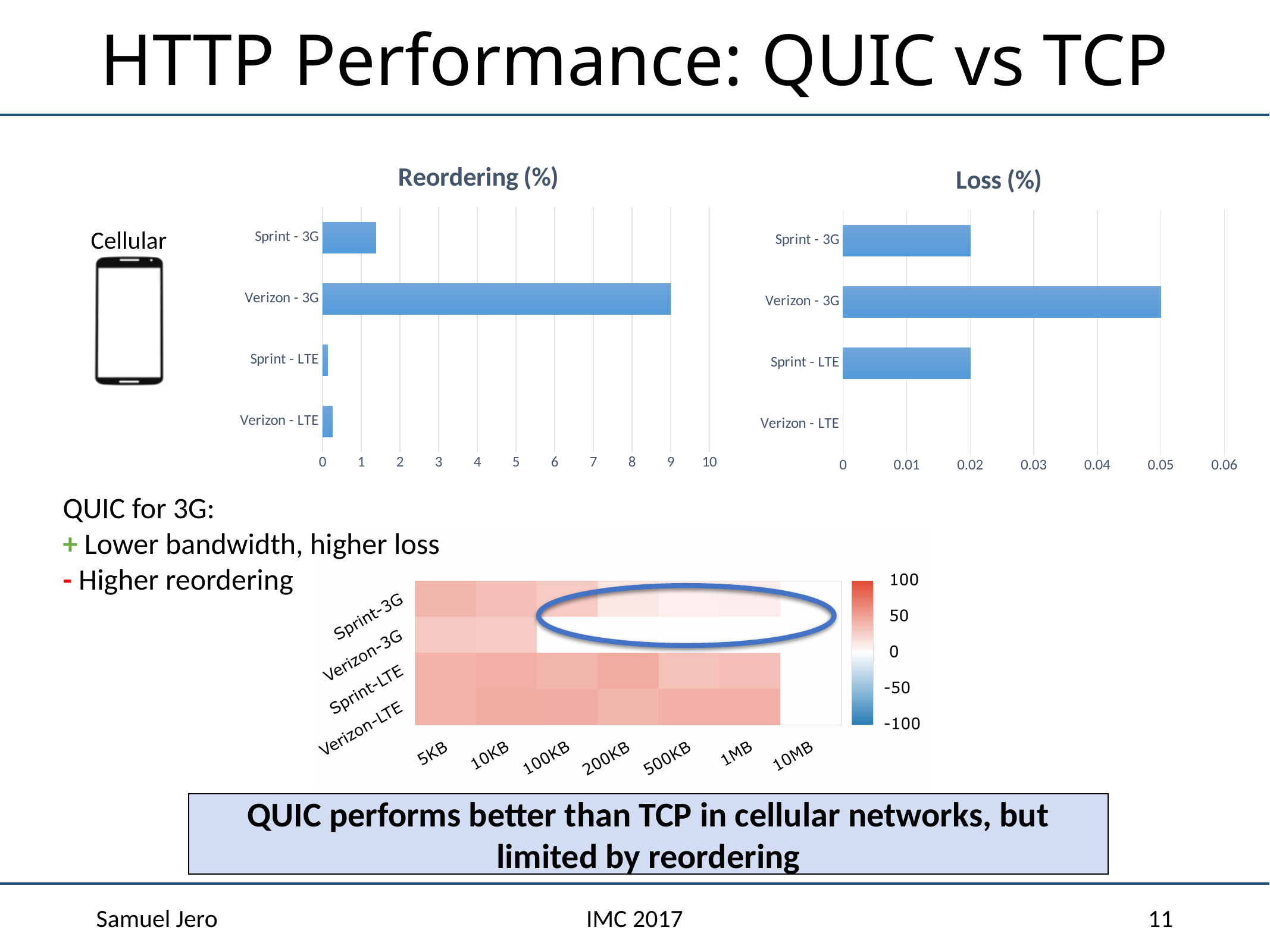
In the heatmap at the bottom of the slide, what are the minimum and maximum values on the colour scale? -100 and 100 What kind of chart is the "Reordering (%)" chart? bar chart In the heatmap at the bottom of the slide, how many file sizes are listed along the x axis? 7 In the "Loss (%)" chart, what is the difference between Verizon - 3G and Sprint - 3G? 0.03 In the "Reordering (%)" chart, which is larger, Sprint - LTE or Verizon - LTE? Verizon - LTE In the "Reordering (%)" chart, which category has the highest value? Verizon - 3G In the "Loss (%)" chart, what is the value for Sprint - 3G? 0.02 In the "Reordering (%)" chart, what is the value for Verizon - 3G? 9 In the "Reordering (%)" chart, is the value for Sprint - 3G greater or less than 2? less In the "Loss (%)" chart, what is the value for Verizon - 3G? 0.05 How many categories are shown in the "Reordering (%)" chart? 4 In the "Loss (%)" chart, which category has the lowest value? Verizon - LTE